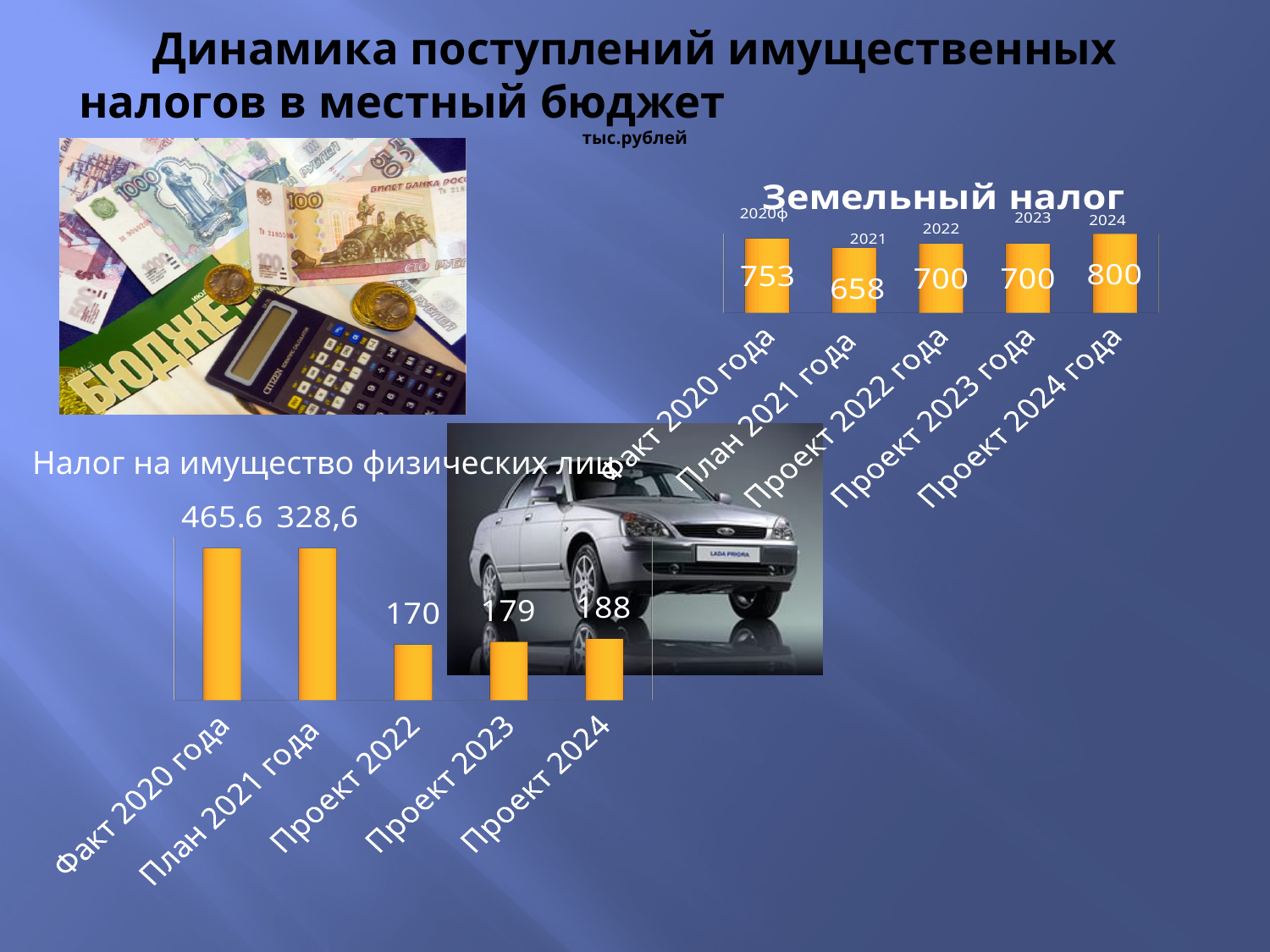
In the 'Налог на имущество физических лиц' chart, which category has the lowest value? Проект 2022 In the 'Налог на имущество физических лиц' chart, what is the difference between Проект 2024 and Проект 2022? 18 In the 'Налог на имущество физических лиц' chart, what is the value for Проект 2023? 179 What type of chart is the 'Налог на имущество физических лиц' chart? Bar chart In the 'Земельный налог' chart, what is the value for Факт 2020 года? 753 In the 'Земельный налог' chart, which category has the highest value? Проект 2024 года In the 'Налог на имущество физических лиц' chart, which is larger: Факт 2020 года or План 2021 года? Факт 2020 года In the 'Земельный налог' chart, what is the value for План 2021 года? 658 In the 'Земельный налог' chart, what is the difference between Проект 2024 года and Факт 2020 года? 47 In the 'Налог на имущество физических лиц' chart, what is the value for Факт 2020 года? 465.6 In the 'Земельный налог' chart, which category has the lowest value? План 2021 года In the 'Земельный налог' chart, how many bars are plotted? 5